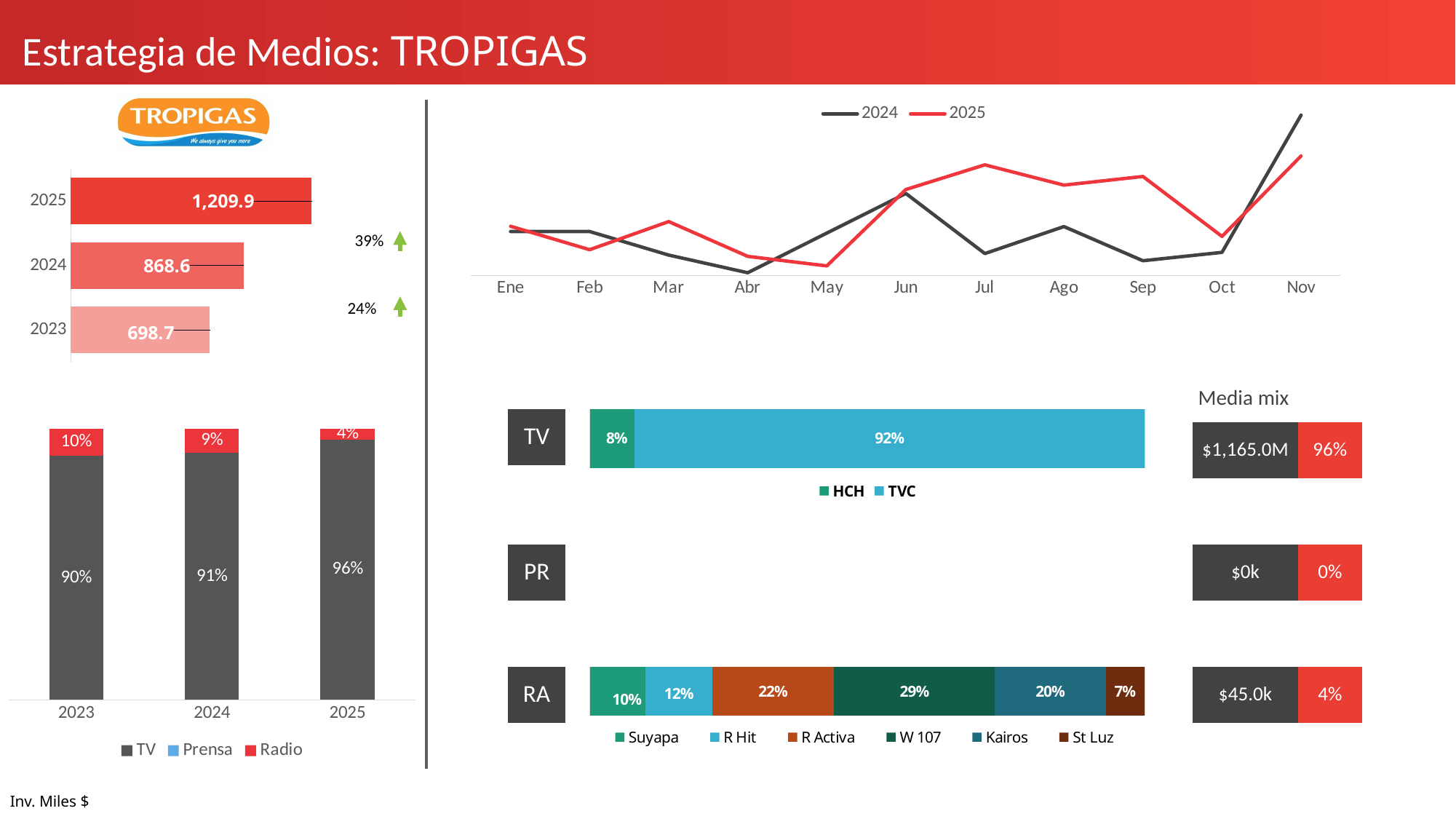
In the bottom-left stacked bar chart, what is the Radio share for 2023? 10% In the top-left bar chart of yearly investment, what is the value for 2023? 698.7 In the bottom-left stacked bar chart, how many series does the legend list? 3 In the top-left bar chart of yearly investment, what is the value for 2025? 1,209.9 What kind of chart is the top-left chart showing values for 2023, 2024 and 2025? bar chart In the TV stacked bar on the right, what is the share for TVC? 92% In the top-right line chart, how many months are shown on the x axis? 11 In the bottom-left stacked bar chart, what is the TV share for 2025? 96% In the top-left bar chart of yearly investment, which year has the highest value? 2025 In the top-right line chart, which series is higher in Nov, 2024 or 2025? 2024 In the RA stacked bar on the right, which station has the largest share? W 107 In the top-left bar chart of yearly investment, what is the difference between the 2025 and 2024 values? 341.3